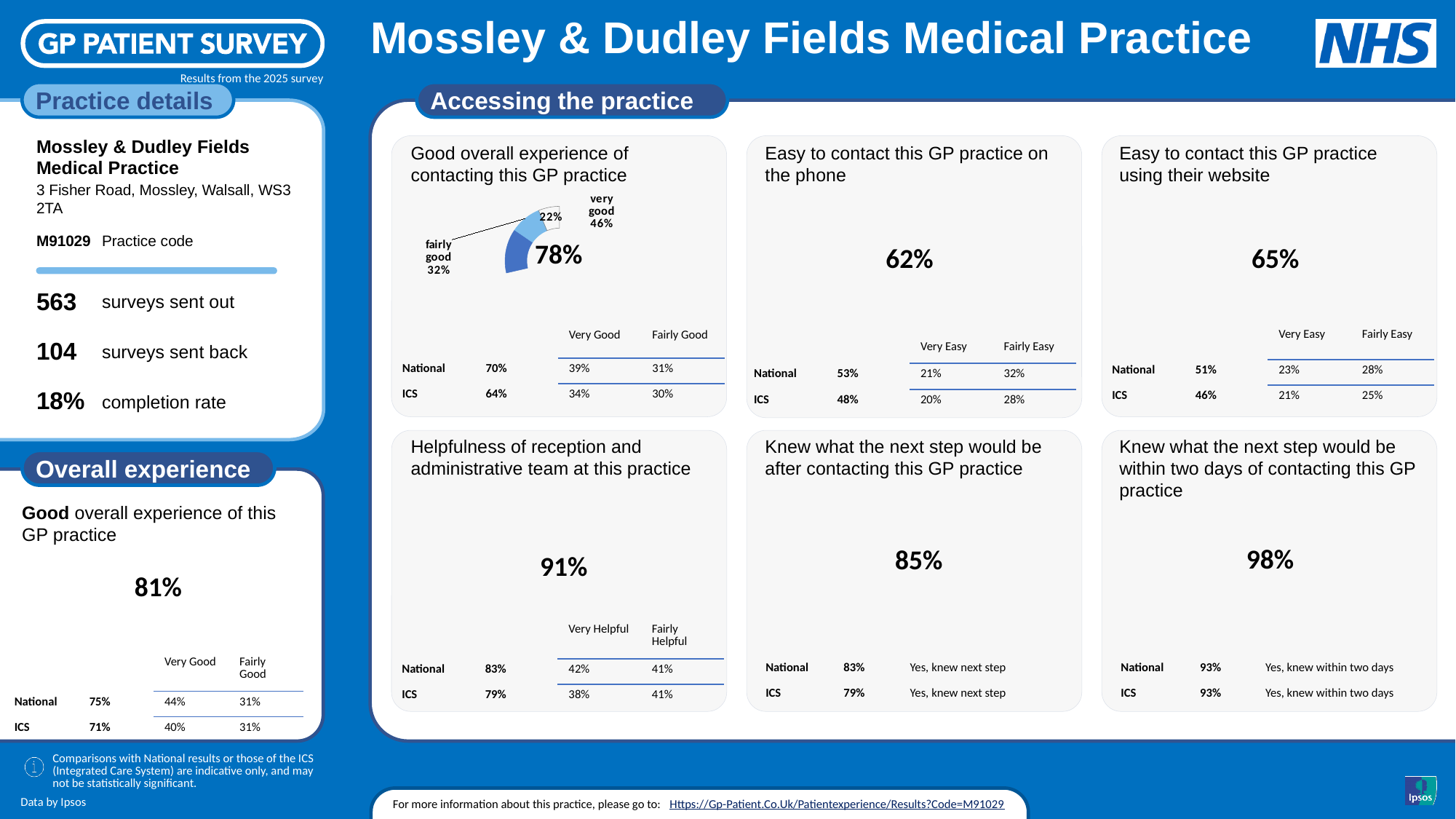
In the 'Good overall experience of contacting this GP practice' chart, what percentage is labelled 'very good'? 46% In the 'Good overall experience of contacting this GP practice' chart, which is larger: 'very good' or 'fairly good'? very good In the 'Good overall experience of contacting this GP practice' panel, is the practice's 78% greater or less than the National figure of 70%? greater What is the title of the panel containing the pie chart? Good overall experience of contacting this GP practice In the 'Good overall experience of contacting this GP practice' panel, what is the ICS overall figure shown in the comparison table? 64% What kind of chart is shown in the 'Good overall experience of contacting this GP practice' panel? pie chart (donut) In the 'Good overall experience of contacting this GP practice' panel, what is the National overall figure shown in the comparison table? 70% In the 'Good overall experience of contacting this GP practice' chart, what percentage is labelled 'fairly good'? 32% What is the large percentage shown in the centre of the 'Good overall experience of contacting this GP practice' chart? 78% In the 'Good overall experience of contacting this GP practice' chart, what do the 'very good' and 'fairly good' percentages add up to? 78% In the 'Good overall experience of contacting this GP practice' chart, what is the difference between the 'very good' and 'fairly good' percentages? 14 percentage points In the 'Good overall experience of contacting this GP practice' chart, is the 'very good' share greater or less than 40%? greater